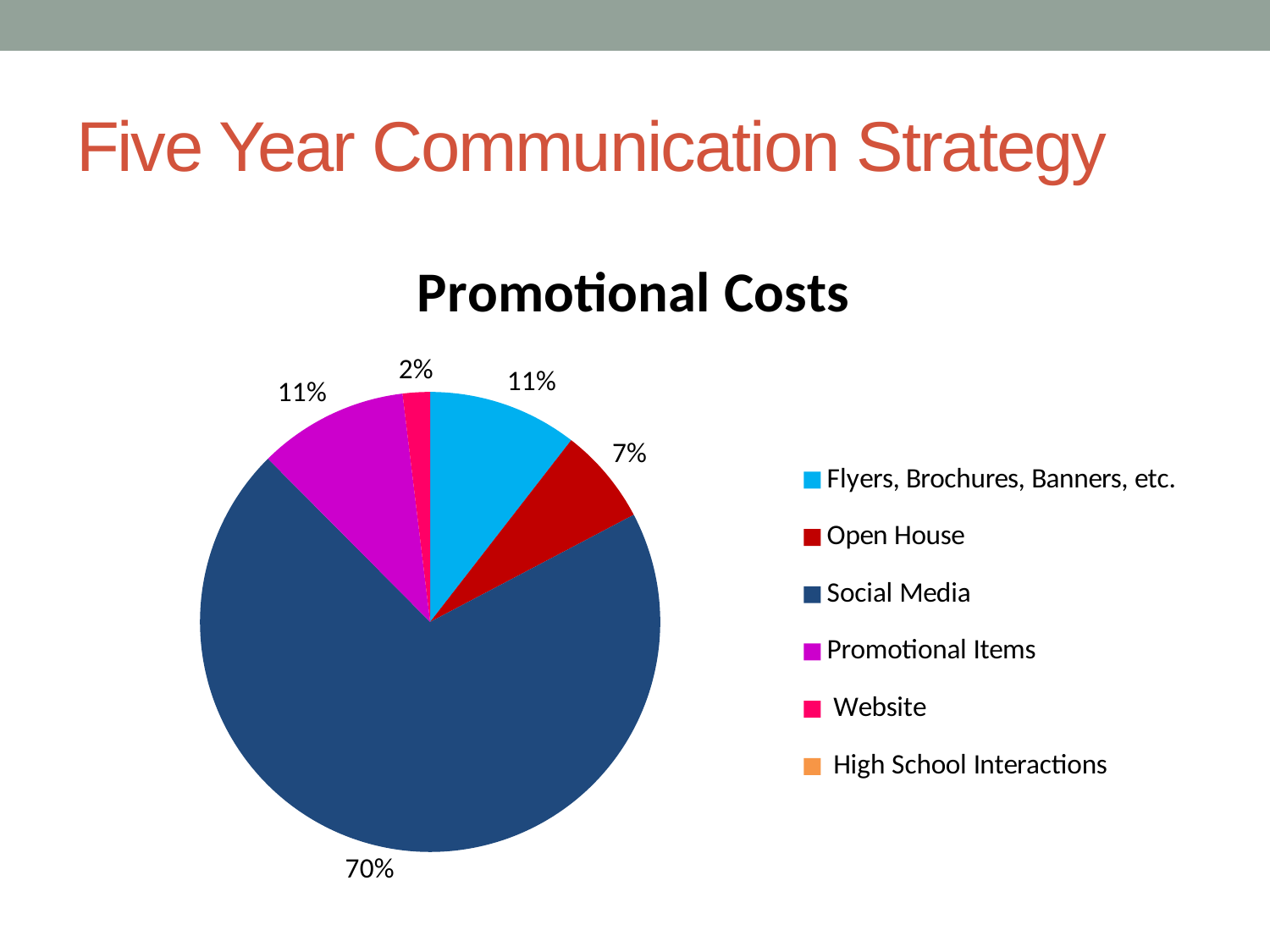
Which is larger, the Open House slice or the Promotional Items slice? Promotional Items What is the title of the chart? Promotional Costs Which labeled slice of the pie is the smallest? Website What percentage is shown for Website? 2% How many percentage points larger is the Social Media slice than the Open House slice? 63 How many entries does the legend list? 6 What percentage is shown for Flyers, Brochures, Banners, etc.? 11% What is the combined share of Flyers, Brochures, Banners, etc. and Promotional Items? 22% What percentage is shown for Open House? 7% What share of promotional costs goes to Social Media? 70% Which category has the largest slice of the pie? Social Media What kind of chart is shown on the slide? pie chart